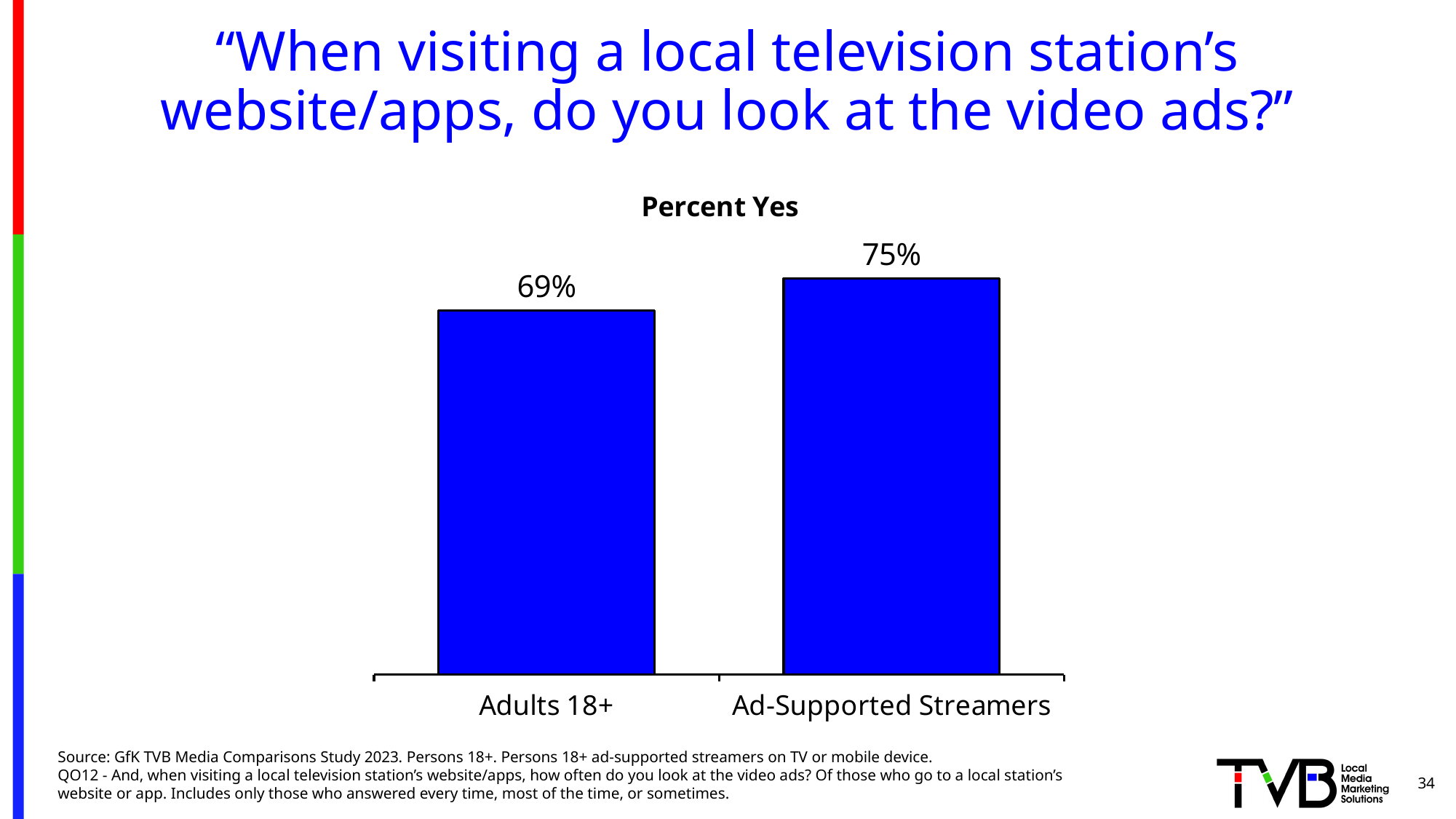
What is the Percent Yes value for Ad-Supported Streamers? 75% What is the Percent Yes value for Adults 18+? 69% What colour are the bars in the chart? Blue What is the title of the chart? Percent Yes What kind of chart is shown on the slide? Bar chart Which category has the lowest Percent Yes value? Adults 18+ What is the difference in Percent Yes between Ad-Supported Streamers and Adults 18+? 6% Which category has the highest Percent Yes value? Ad-Supported Streamers How many categories are shown in the chart? 2 Which is larger, the Percent Yes for Adults 18+ or for Ad-Supported Streamers? Ad-Supported Streamers